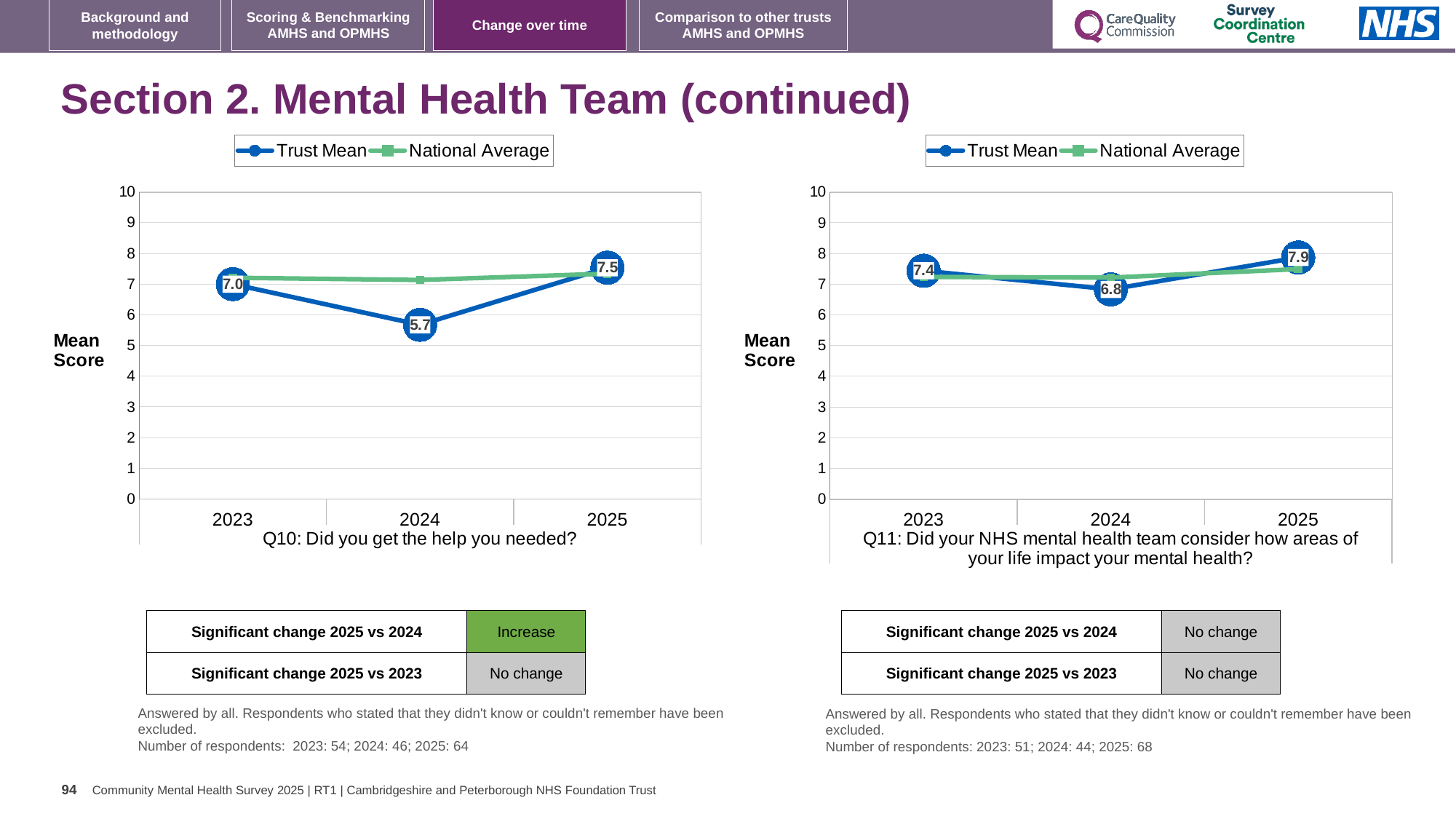
In the Q11 chart (right), what is the difference between the Trust Mean for 2025 and 2024? 1.1 In the Q10 chart (left), what is the Trust Mean for 2024? 5.7 What kind of chart is the Q11 chart (right)? Line chart In the Q11 chart (right), what is the Trust Mean for 2023? 7.4 In the Q11 chart (right), is the Trust Mean for 2025 greater or less than the National Average for 2025? greater In the Q10 chart (left), does the Trust Mean rise or fall from 2024 to 2025? Rise In the Q11 chart (right), which year has the highest Trust Mean? 2025 How many series does the legend of the Q10 chart (left) list? 2 In the Q10 chart (left), is the National Average for 2024 greater or less than 6? greater In the Q10 chart (left), what is the Trust Mean for 2025? 7.5 In the Q10 chart (left), which year has the lowest Trust Mean? 2024 In the Q10 chart (left), what is the difference between the Trust Mean for 2025 and 2024? 1.8